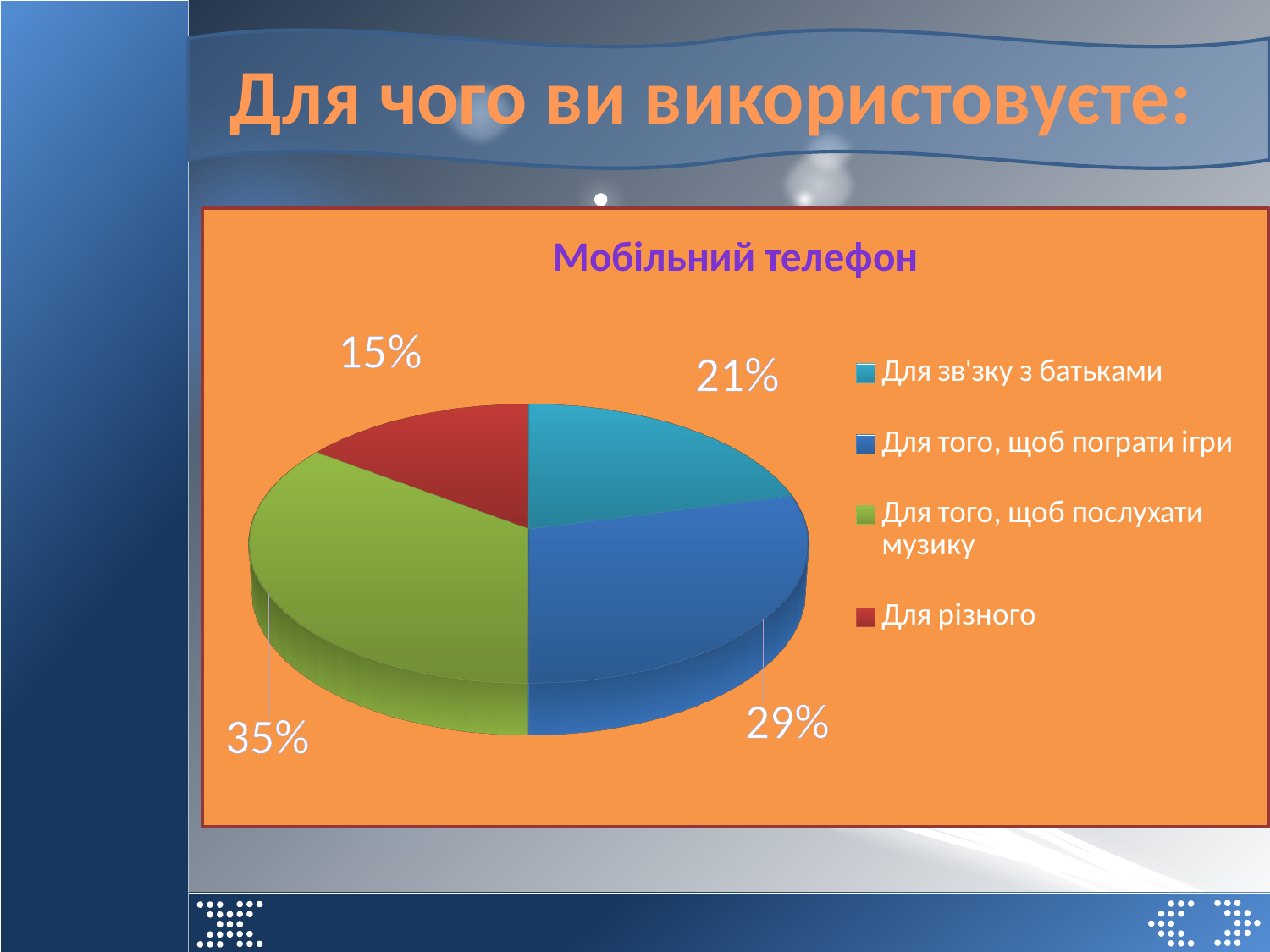
What is the difference in percentage points between 'Для того, щоб послухати музику' and 'Для різного'? 20 What colour is the slice for 'Для різного'? Red How many slices does the pie chart have? 4 Which category has the largest share of the pie? Для того, щоб послухати музику What share of the pie is 'Для того, щоб послухати музику'? 35% What is the title of the chart? Мобільний телефон What kind of chart is shown on the slide? Pie chart Which category has the smallest share of the pie? Для різного What share of the pie is 'Для того, щоб пограти ігри'? 29% What share of the pie is 'Для різного'? 15% Which is larger: the share for 'Для того, щоб пограти ігри' or the share for 'Для зв'зку з батьками'? Для того, щоб пограти ігри